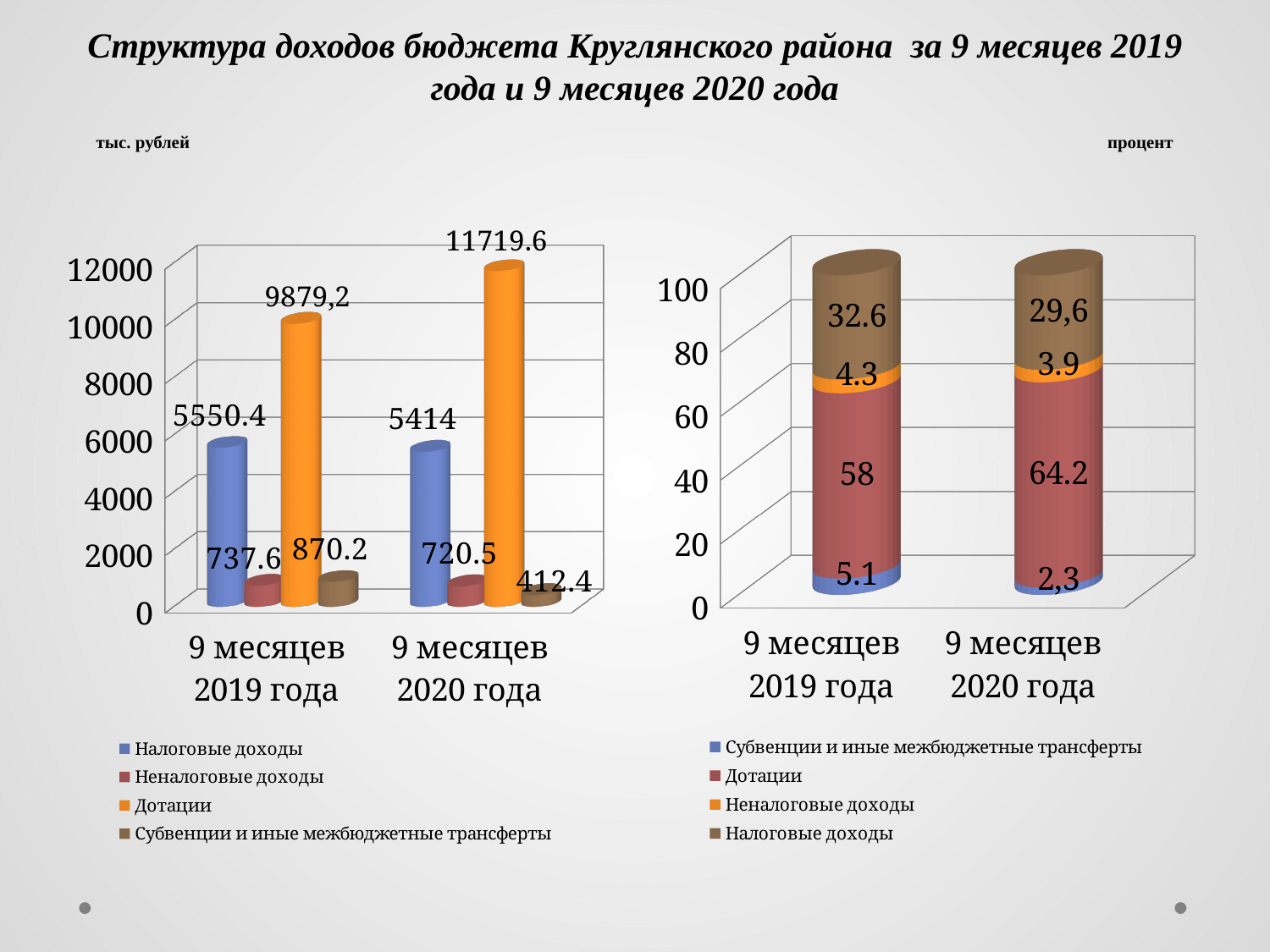
In the left chart (тыс. рублей), what is the difference between Дотации for 9 месяцев 2020 года and Дотации for 9 месяцев 2019 года? 1840.4 In the left chart (тыс. рублей), which is larger: Неналоговые доходы for 9 месяцев 2019 года or for 9 месяцев 2020 года? 9 месяцев 2019 года In the right chart (процент), what is the total of the stacked bar for 9 месяцев 2019 года? 100 In the left chart (тыс. рублей), what is the value of Дотации for 9 месяцев 2020 года? 11719.6 What kind of chart is the right chart (процент)? Stacked bar chart In the left chart (тыс. рублей), which series has the highest value for 9 месяцев 2019 года? Дотации In the left chart (тыс. рублей), how many series does the legend list? 4 In the right chart (процент), what is the value of Налоговые доходы for 9 месяцев 2019 года? 32.6 In the right chart (процент), what is the value of Дотации for 9 месяцев 2020 года? 64.2 In the left chart (тыс. рублей), what is the value of Субвенции и иные межбюджетные трансферты for 9 месяцев 2020 года? 412.4 In the left chart (тыс. рублей), what is the value of Налоговые доходы for 9 месяцев 2019 года? 5550.4 In the left chart (тыс. рублей), which series has the lowest value for 9 месяцев 2020 года? Субвенции и иные межбюджетные трансферты